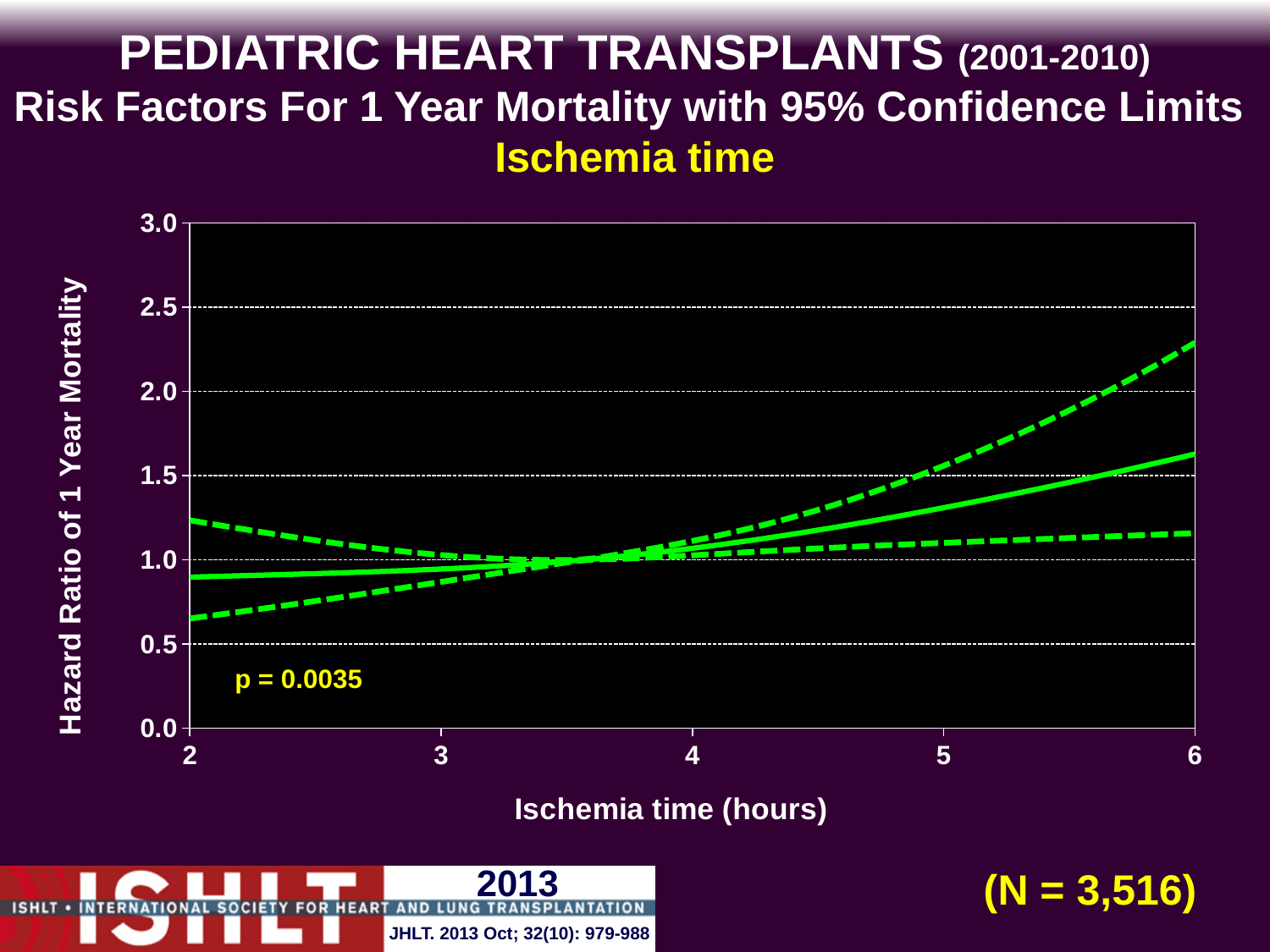
Is the upper 95% confidence limit (upper dashed line) at an ischemia time of 6 hours greater or less than 2.0? greater Is the lower 95% confidence limit (lower dashed line) at an ischemia time of 6 hours greater or less than 1.0? greater What is the label of the x axis? Ischemia time (hours) Is the hazard ratio (solid line) at an ischemia time of 2 hours greater or less than 1.0? less What p-value is shown on the chart? p = 0.0035 How many lines are plotted on the chart? 3 Does the solid hazard ratio line rise or fall as ischemia time increases from 2 to 6 hours? rise What kind of chart is shown on the slide? line chart